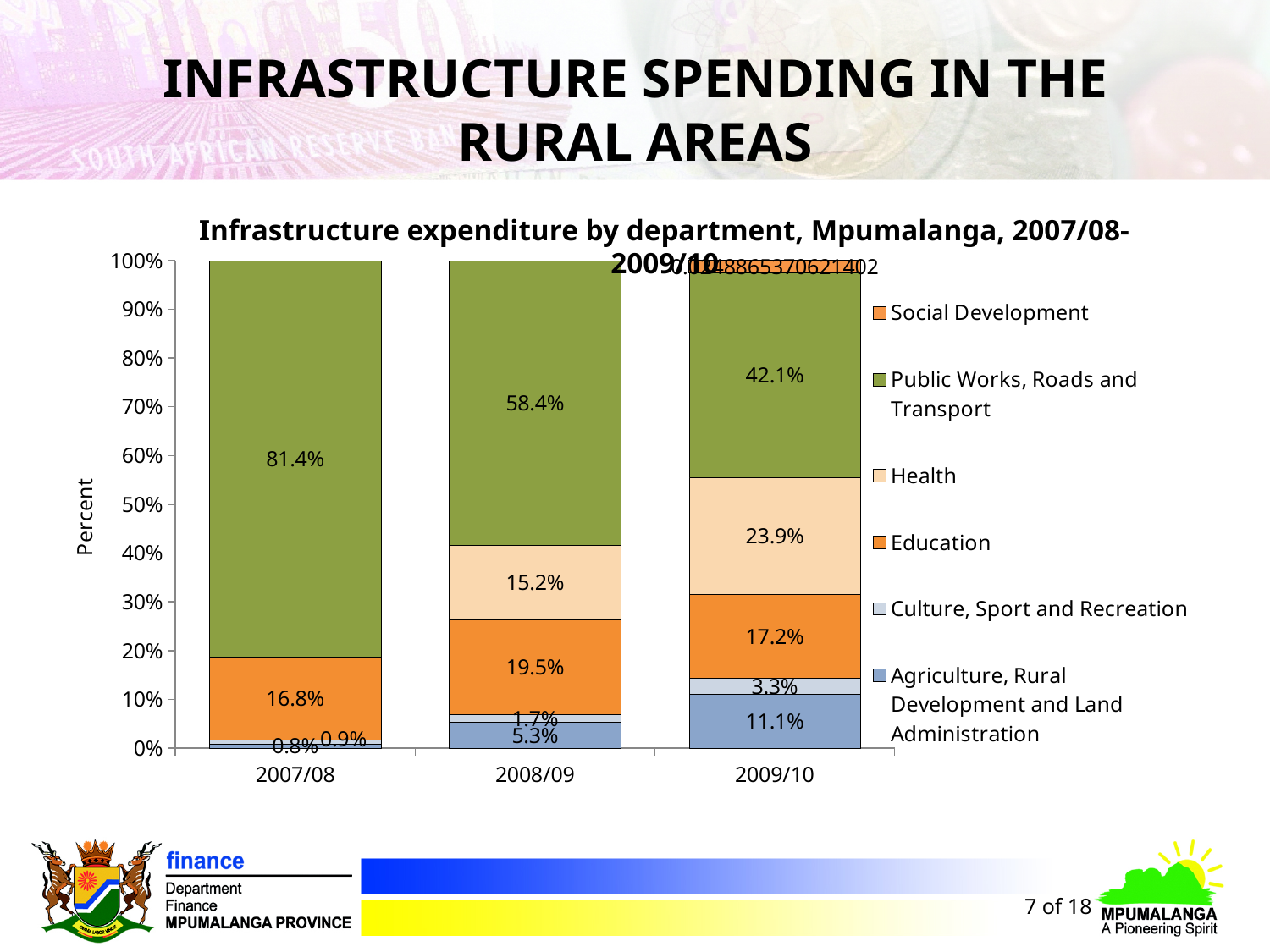
By how many percentage points did the Public Works, Roads and Transport share fall from 2007/08 to 2009/10? 39.3 What share of infrastructure expenditure went to Health in 2008/09? 15.2% How many series does the legend list? 6 What type of chart is shown on the slide? stacked bar chart Does the Health share rise or fall from 2008/09 to 2009/10? rise What share of infrastructure expenditure went to Agriculture, Rural Development and Land Administration in 2009/10? 11.1% What share of infrastructure expenditure went to Education in 2009/10? 17.2% Which department is shown in green in the chart? Public Works, Roads and Transport Which is larger in 2008/09: the Education share or the Health share? Education How many financial years are shown on the x axis? 3 What share of infrastructure expenditure went to Public Works, Roads and Transport in 2007/08? 81.4% In which year was the Public Works, Roads and Transport share the highest? 2007/08